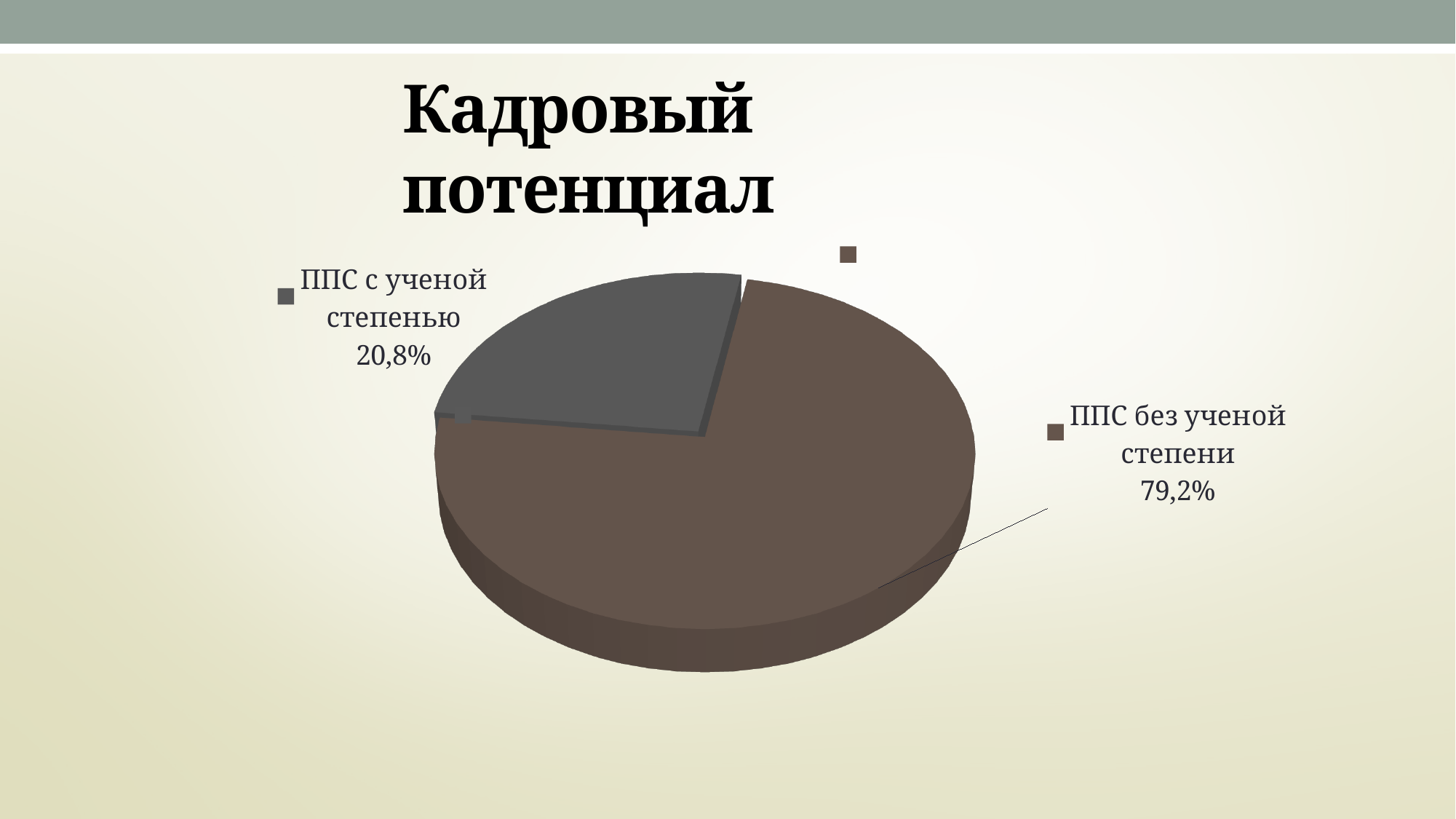
What share of the pie is labelled "ППС без ученой степени"? 79,2% Which slice of the pie is the largest? ППС без ученой степени What is the difference in percentage points between "ППС без ученой степени" and "ППС с ученой степенью"? 58,4 What share of the pie is labelled "ППС с ученой степенью"? 20,8% What kind of chart is shown on the slide? pie chart Which slice is shown in the lighter grey colour? ППС с ученой степенью What is the title of the chart? Кадровый потенциал What is the total of the two slice percentages shown? 100% Which is larger: the share for "ППС с ученой степенью" or the share for "ППС без ученой степени"? ППС без ученой степени Which slice of the pie is the smallest? ППС с ученой степенью How many slices does the pie chart have? 2